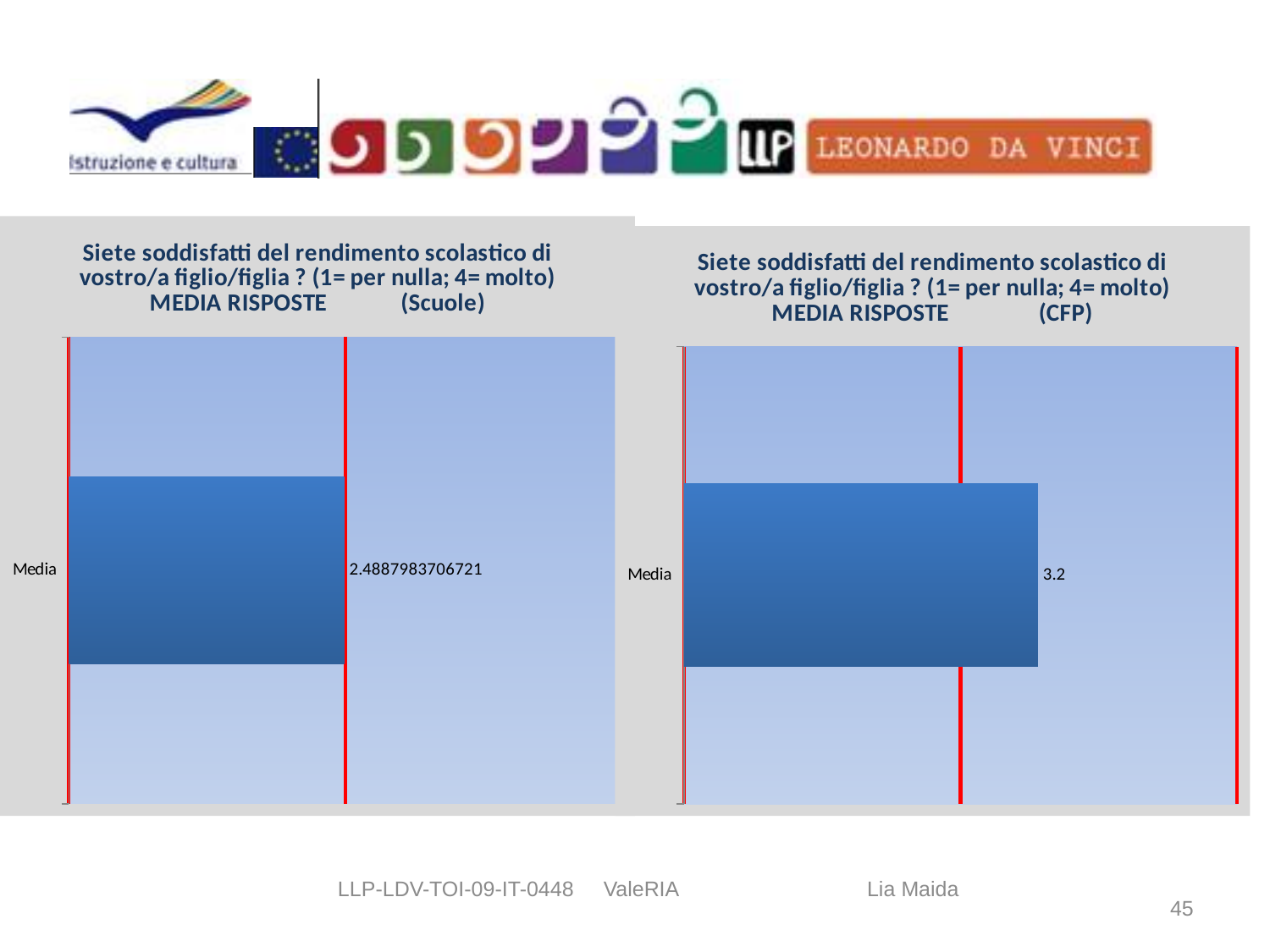
What is the category label on the right chart (CFP)? Media Is the Media value on the left chart (Scuole) greater or less than the Media value on the right chart (CFP)? less On the left chart (Scuole), what is the value shown for Media? 2.4887983706721 What kind of chart is the right chart (CFP)? Bar chart How many categories are plotted on the left chart (Scuole)? 1 How many categories are plotted on the right chart (CFP)? 1 What kind of chart is the left chart (Scuole)? Bar chart What is the difference between the Media value on the CFP chart and the Media value on the Scuole chart? 0.7112016293279 According to the chart titles, what response scale is used (1 = ? ; 4 = ?)? 1= per nulla; 4= molto Which chart shows the higher Media value, the Scuole chart on the left or the CFP chart on the right? CFP (right) On the right chart (CFP), what is the value shown for Media? 3.2